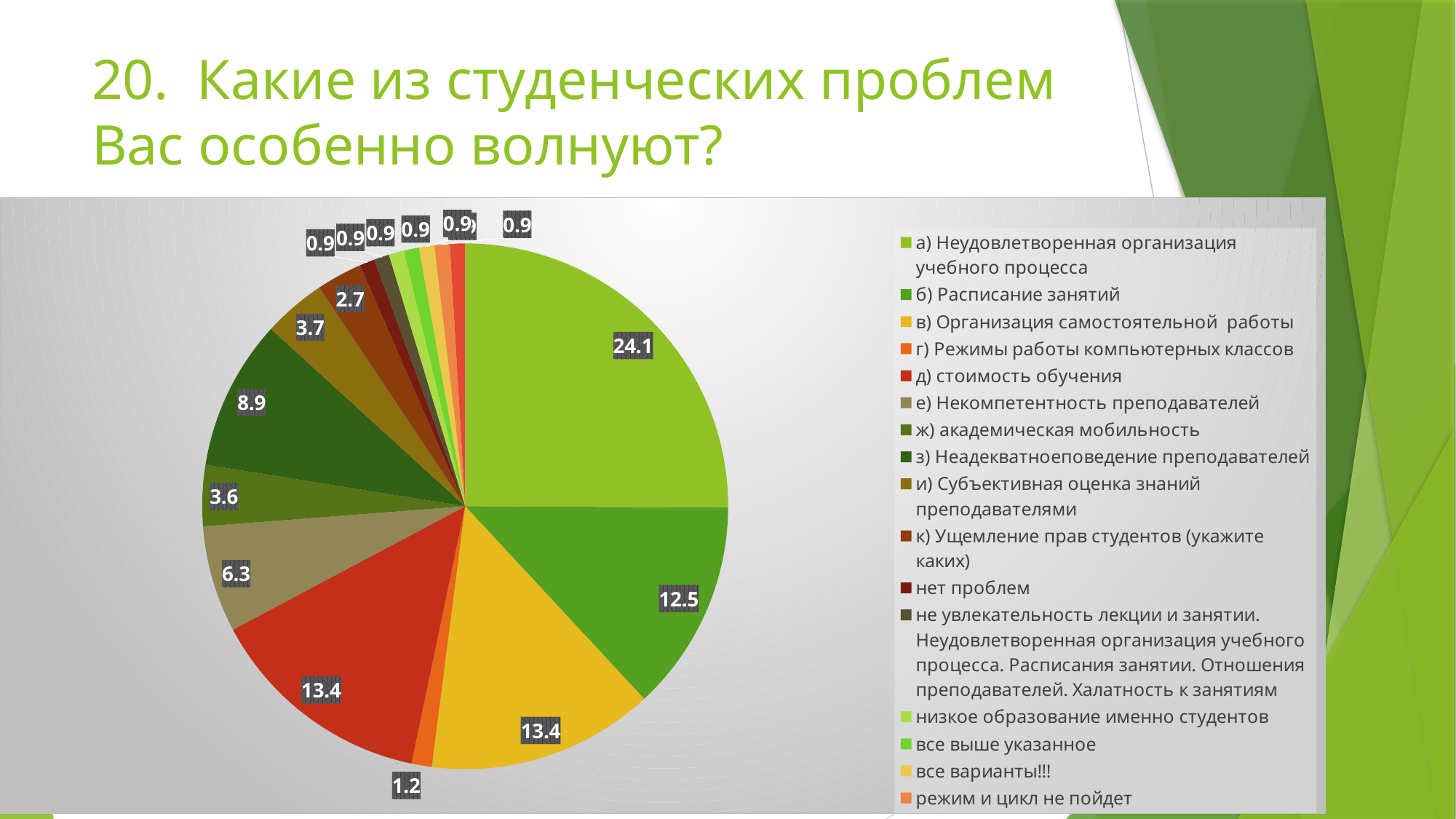
What is the value shown for з) Неадекватное поведение преподавателей? 8.9 What is the value shown for б) Расписание занятий? 12.5 What is the value shown for е) Некомпетентность преподавателей? 6.3 What is the value shown for д) стоимость обучения? 13.4 How many entries does the legend list? 16 What is the value shown for г) Режимы работы компьютерных классов? 1.2 Which category has the largest share of the pie? а) Неудовлетворенная организация учебного процесса What is the value shown for а) Неудовлетворенная организация учебного процесса? 24.1 What kind of chart is shown on the slide? pie chart Which is larger: the value for з) Неадекватное поведение преподавателей or е) Некомпетентность преподавателей? з) Неадекватное поведение преподавателей What is the value shown for к) Ущемление прав студентов? 2.7 What is the difference between the values for а) Неудовлетворенная организация учебного процесса and б) Расписание занятий? 11.6